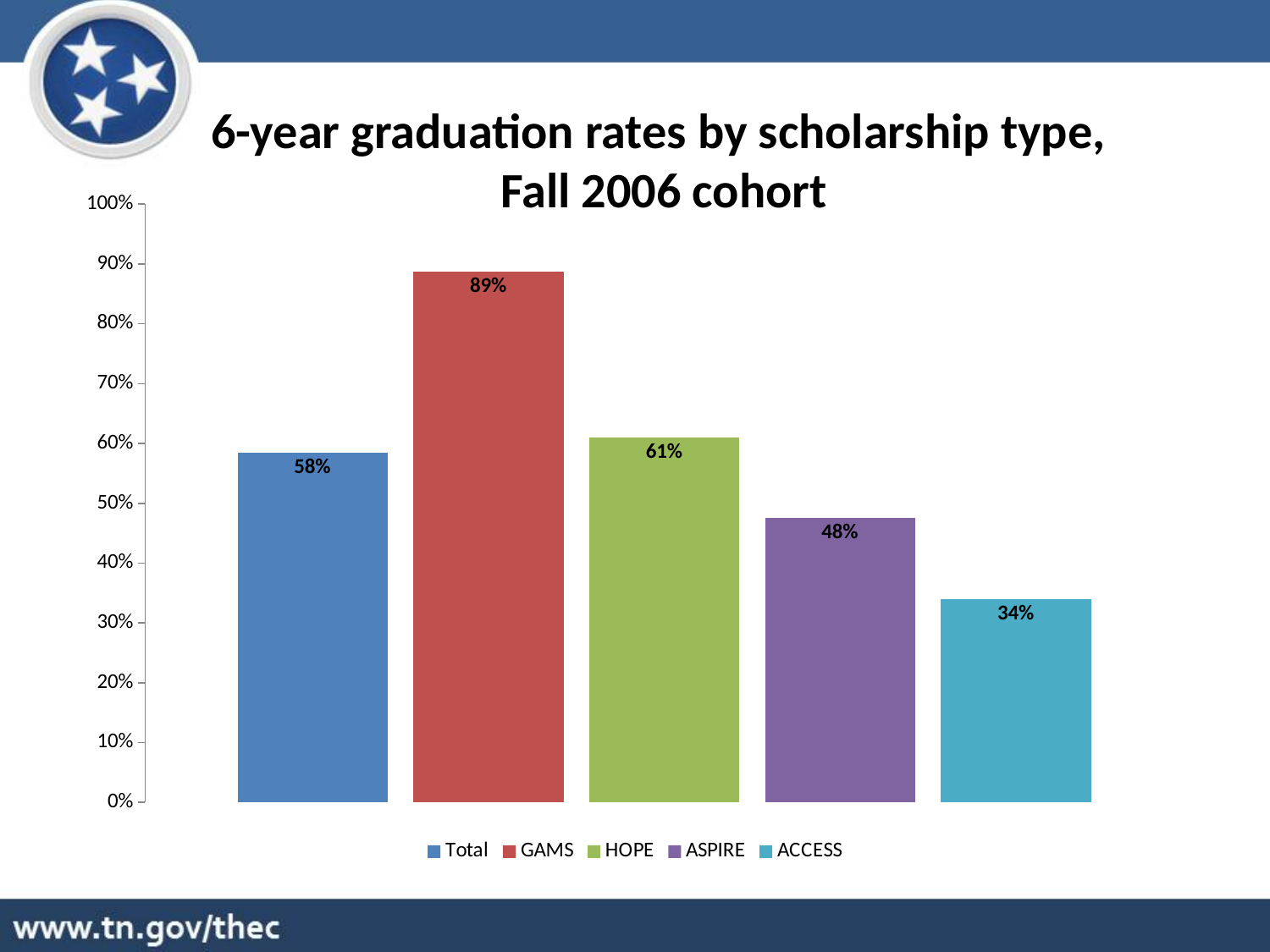
What is the Total 6-year graduation rate shown? 58% What kind of chart is shown on the slide? Bar chart Which scholarship type has the lowest 6-year graduation rate? ACCESS What is the 6-year graduation rate for GAMS? 89% What is the 6-year graduation rate for HOPE? 61% What is the difference between the GAMS and ASPIRE graduation rates? 41% How many bars are shown in the chart? 5 Which scholarship type has the highest 6-year graduation rate? GAMS Is the graduation rate for ASPIRE greater or less than 50%? less What is the 6-year graduation rate for ACCESS? 34% What colour is the GAMS bar? Red Which has a higher graduation rate, HOPE or ASPIRE? HOPE